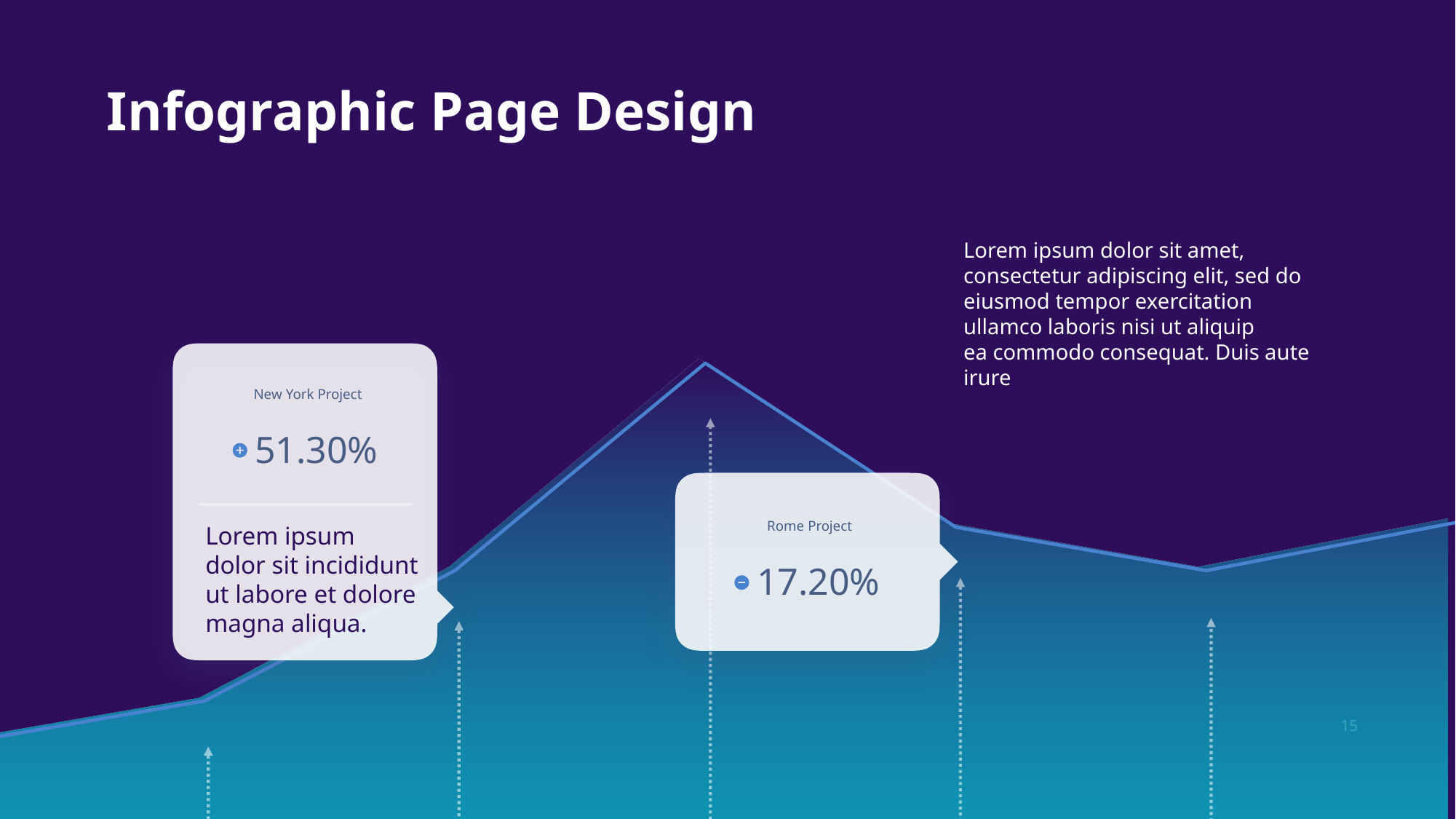
Which project's value is marked with a minus sign? Rome Project What value is shown for the Rome Project? 17.20% Which project's value is marked with a plus sign? New York Project What value is shown for the New York Project? 51.30% What kind of chart is shown on the slide? area chart Which project shows the larger value, New York Project or Rome Project? New York Project What is the difference between the New York Project value and the Rome Project value? 34.10%